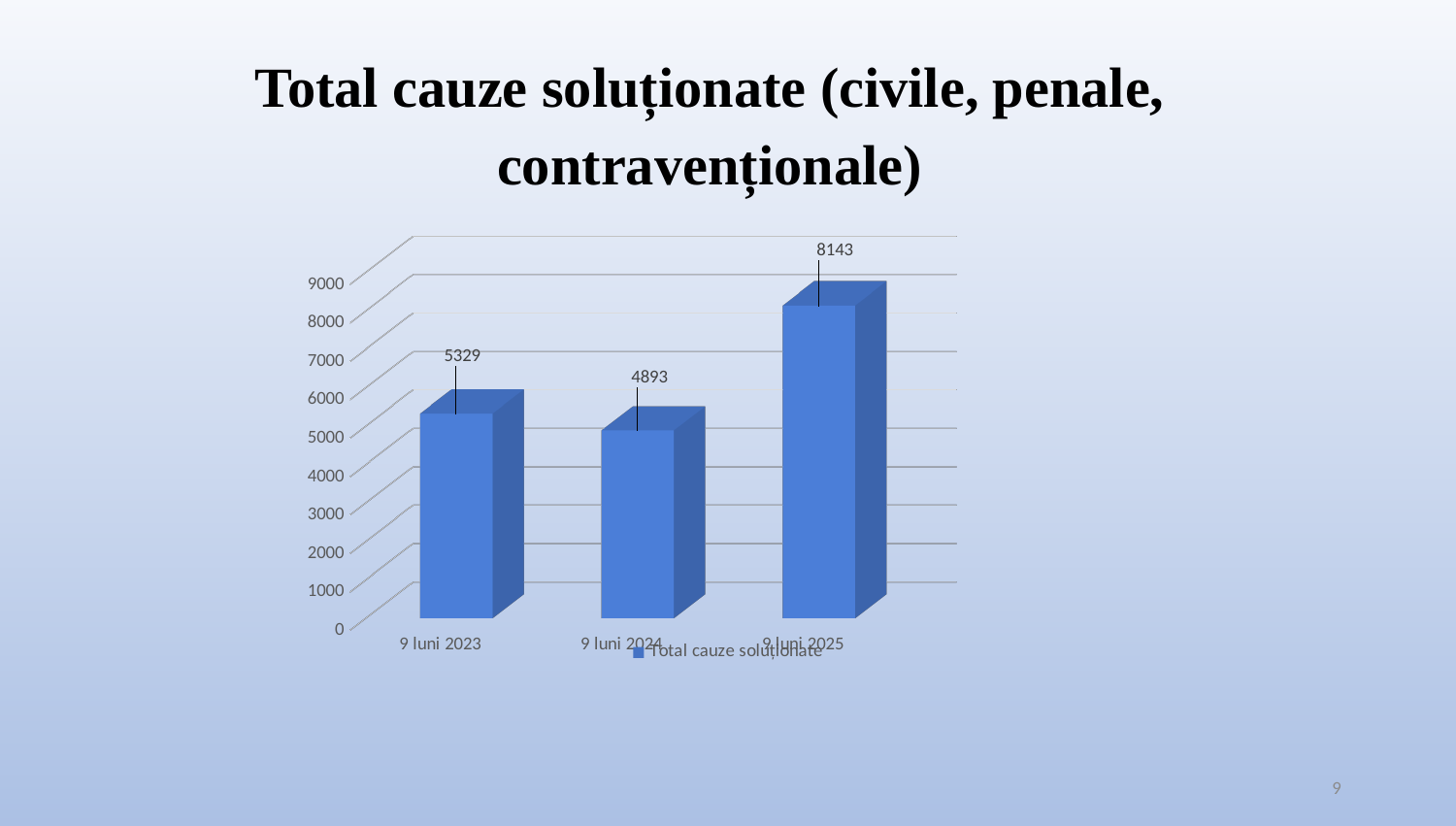
How many categories are shown on the x axis? 3 What is the difference between the values for 9 luni 2025 and 9 luni 2023? 2814 What kind of chart is shown on the slide? bar chart What is the value for 9 luni 2025? 8143 Which category has the highest value? 9 luni 2025 What is the value for 9 luni 2023? 5329 Which category has the lowest value? 9 luni 2024 What is the value for 9 luni 2024? 4893 What is the difference between the values for 9 luni 2023 and 9 luni 2024? 436 Which is larger, the value for 9 luni 2023 or 9 luni 2024? 9 luni 2023 Is the value for 9 luni 2025 greater or less than 7000? greater What is the legend entry shown below the chart? Total cauze soluționate